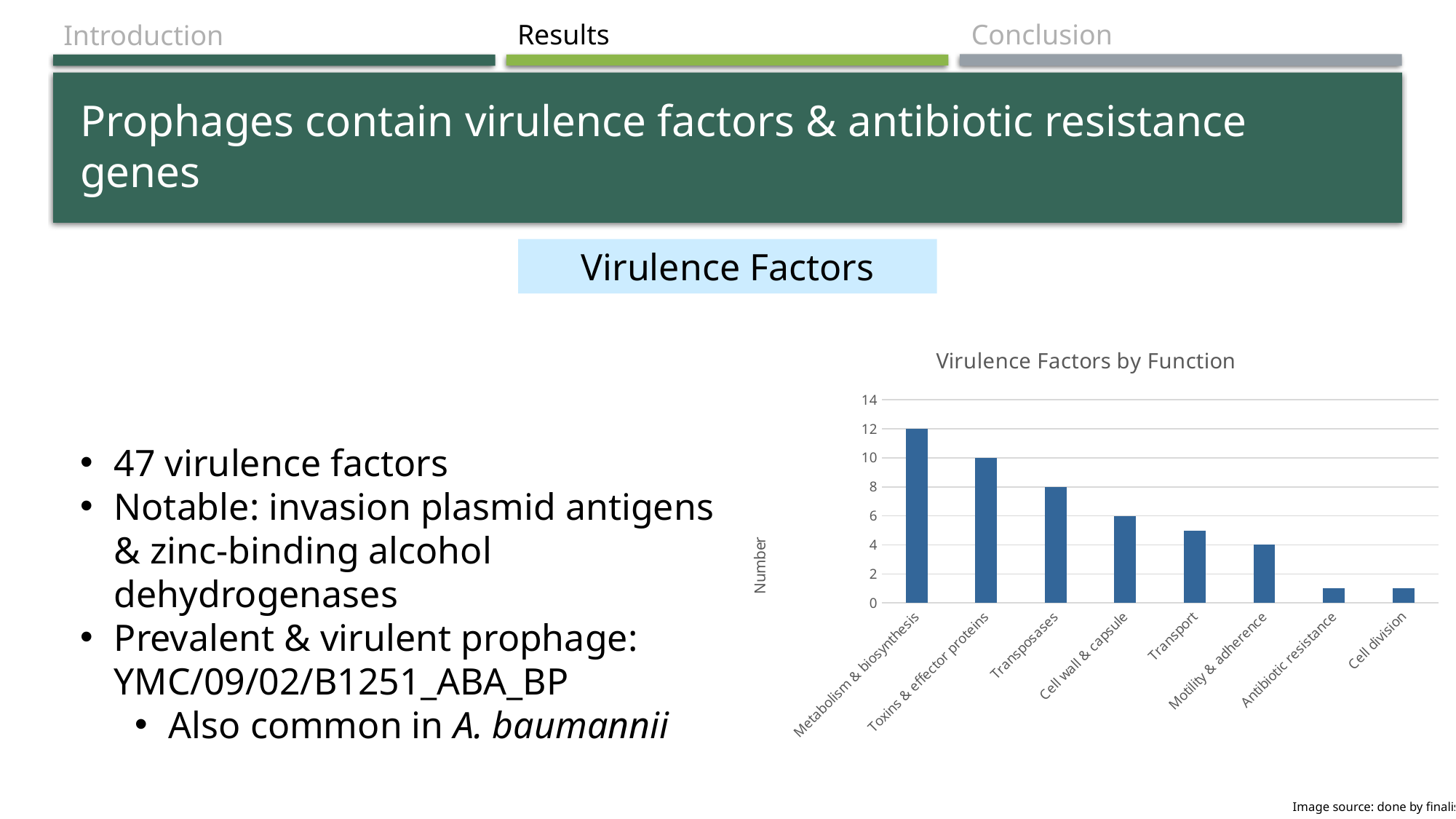
What is the value for Cell wall & capsule? 6 What is the value for Metabolism & biosynthesis? 12 Which category has the highest value in the chart? Metabolism & biosynthesis What type of chart is shown on the slide? Bar chart What is the value for Motility & adherence? 4 How many categories are shown on the x axis of the chart? 8 What is the value for Toxins & effector proteins? 10 Is the value for Antibiotic resistance greater or less than 2? less Is the value for Transport greater or less than 4? greater What is the value for Transposases? 8 What is the title of the chart? Virulence Factors by Function What is the difference between the values for Metabolism & biosynthesis and Transposases? 4